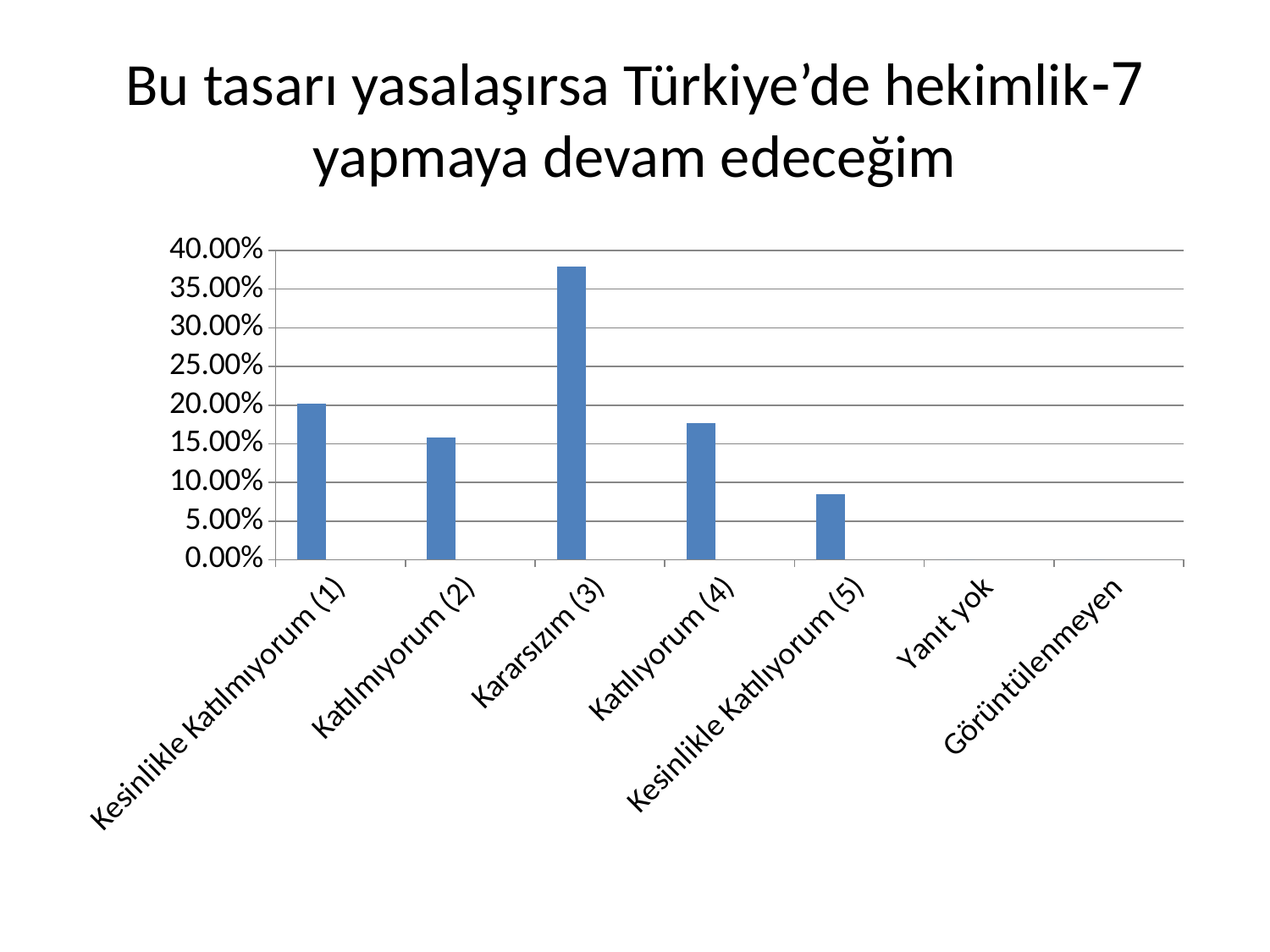
Is the value for Katılıyorum (4) greater or less than 20.00%? less Is the value for Kesinlikle Katılmıyorum (1) greater or less than 15.00%? greater Which category has the highest value in the chart? Kararsızım (3) Which is larger, the value for Kesinlikle Katılmıyorum (1) or the value for Katılmıyorum (2)? Kesinlikle Katılmıyorum (1) What colour are the bars in the chart? blue Is the value for Kesinlikle Katılıyorum (5) greater or less than 10.00%? less What kind of chart is shown on the slide? bar chart What is the highest value shown on the y axis of the chart? 40.00% Which is larger, the value for Katılıyorum (4) or the value for Kesinlikle Katılıyorum (5)? Katılıyorum (4) How many categories are shown on the x axis of the chart? 7